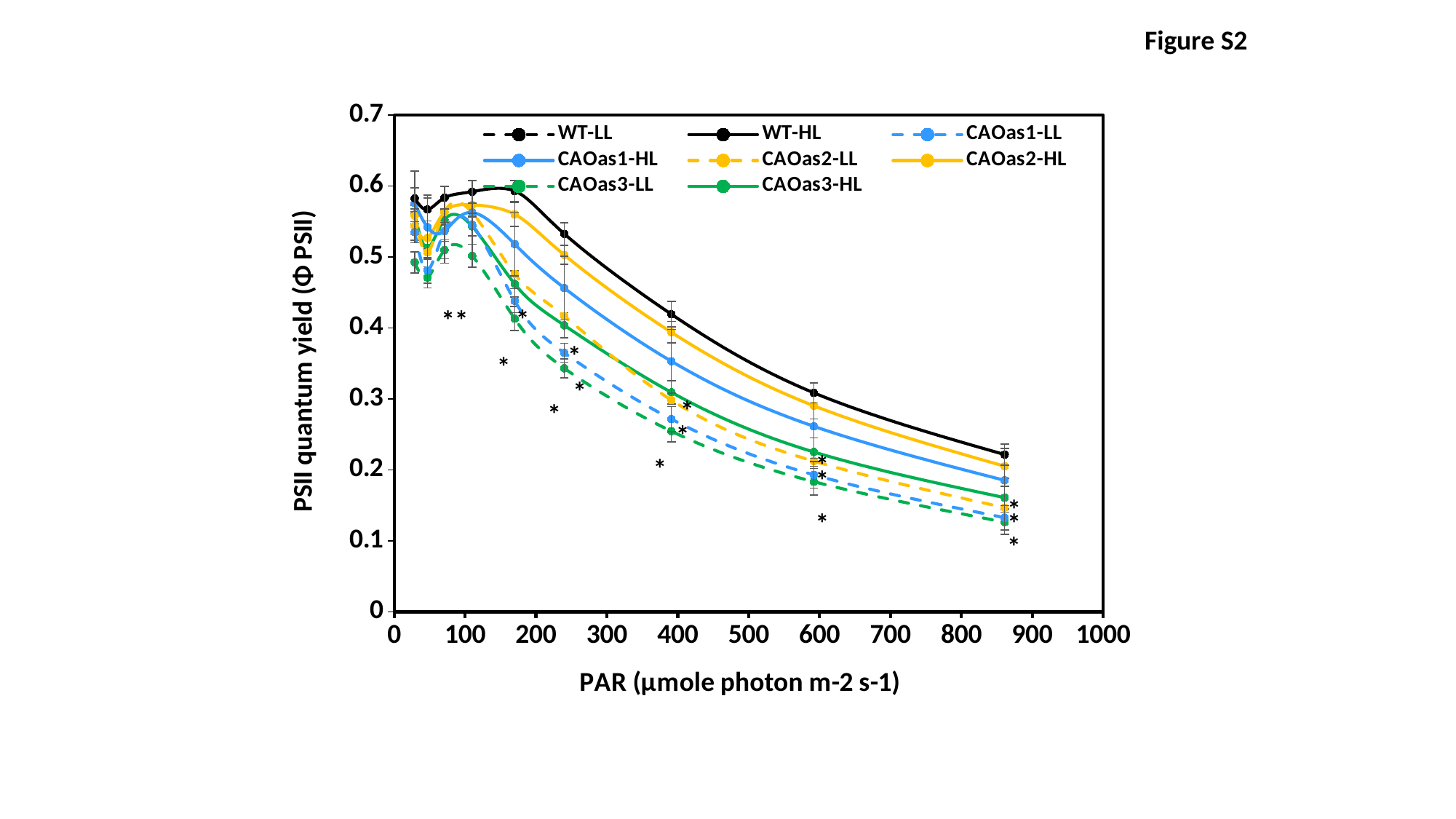
What is the title of the y axis? PSII quantum yield (Φ PSII) Is the value for CAOas1-HL at PAR around 600 greater or less than 0.3? less How many series does the legend list? 8 What kind of chart is shown on the slide? line chart At PAR around 400, which series has the larger PSII quantum yield, WT-HL or CAOas1-LL? WT-HL Which series has the highest PSII quantum yield at the highest PAR level (around 860)? WT-HL Is the value for CAOas3-LL at the highest PAR level (around 860) greater or less than 0.2? less Do the PSII quantum yield values rise or fall as PAR increases from 200 to 900? fall What is the title of the x axis? PAR (µmole photon m-2 s-1) Is the value for WT-HL at PAR around 400 greater or less than 0.4? greater